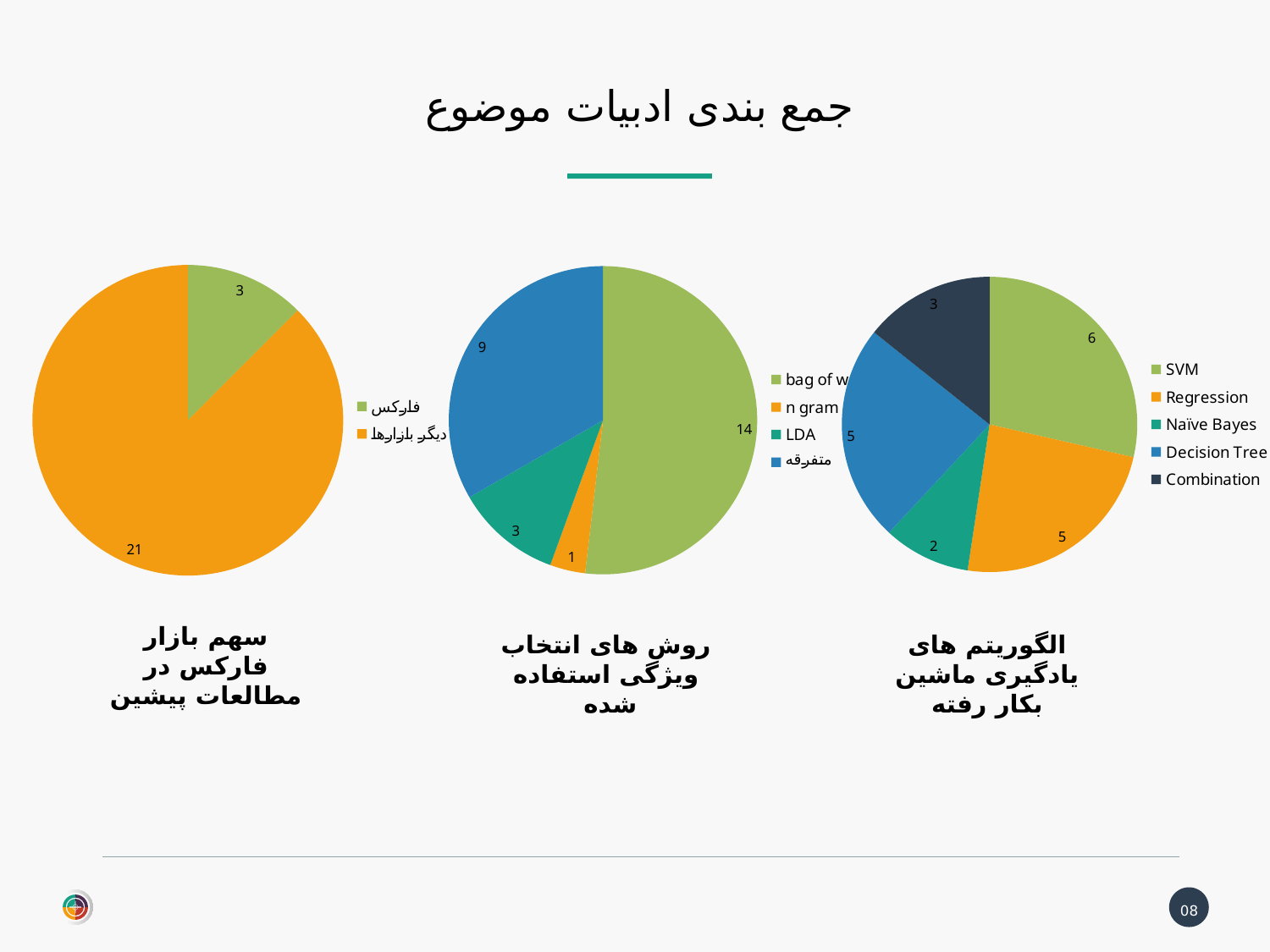
In the left pie chart, what is the value of the smaller (green) slice? 3 In the middle pie chart, what is the value for n gram? 1 In the middle pie chart, what is the value for LDA? 3 In the right pie chart, what is the difference between SVM and Combination? 3 In the right pie chart, what is the value for SVM? 6 In the left pie chart, what is the value of the larger slice? 21 In the right pie chart, which category has the smallest slice? Naïve Bayes In the middle pie chart, which category has the largest slice? bag of word In the left pie chart, what is the difference between the two slices? 18 In the middle pie chart, how many categories does the legend list? 4 In the left pie chart, what share of the total does the slice labelled 21 represent? 87.5% What type of chart is used for the three charts on the slide? Pie chart